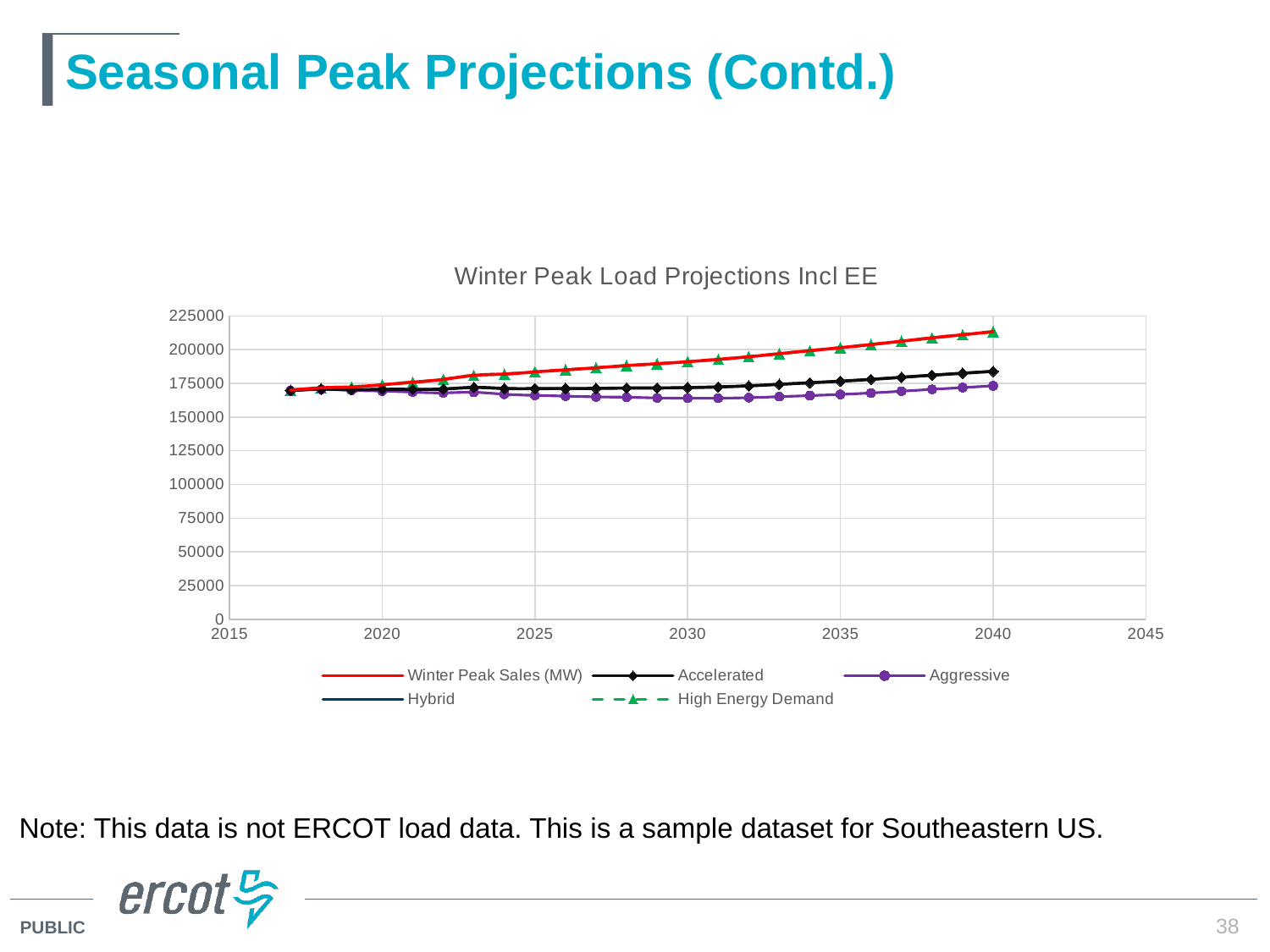
What is the title of the chart? Winter Peak Load Projections Incl EE Is the value for Accelerated in 2040 greater or less than 175000? greater In 2035, which is larger: High Energy Demand or Accelerated? High Energy Demand What kind of chart is shown on the slide? line chart In 2040, which is larger: Accelerated or Aggressive? Accelerated Is the value for High Energy Demand in 2040 greater or less than 200000? greater Is the value for Winter Peak Sales (MW) in 2040 greater or less than 200000? greater Does the High Energy Demand series rise or fall from 2017 to 2040? rise How many series does the legend list? 5 Which series is plotted with green triangle markers and a dashed line? High Energy Demand Which series has the lowest value in 2040? Aggressive